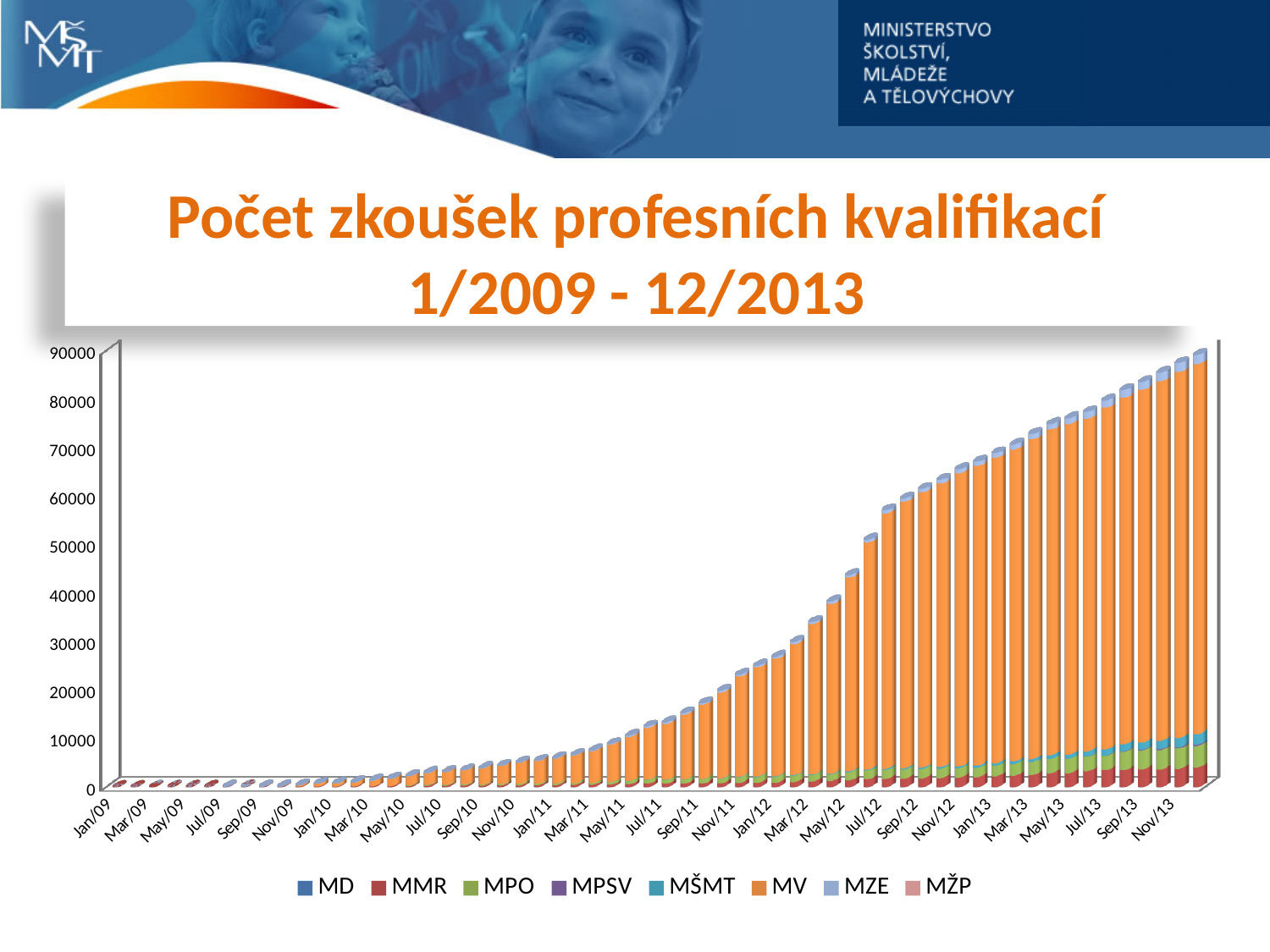
What kind of chart is shown on the slide? stacked bar chart Which has the larger total, Jan/09 or Nov/13? Nov/13 Is the total for Nov/13 greater or less than 80000? greater Which series is listed first in the legend? MD Is the total for Jan/10 greater or less than 10000? less Do the bar totals rise or fall from Jan/09 to Nov/13? rise Which series accounts for the largest part of each bar? MV What is the highest value shown on the vertical axis? 90000 Is the total for Jul/11 greater or less than 20000? less How many series does the legend list? 8